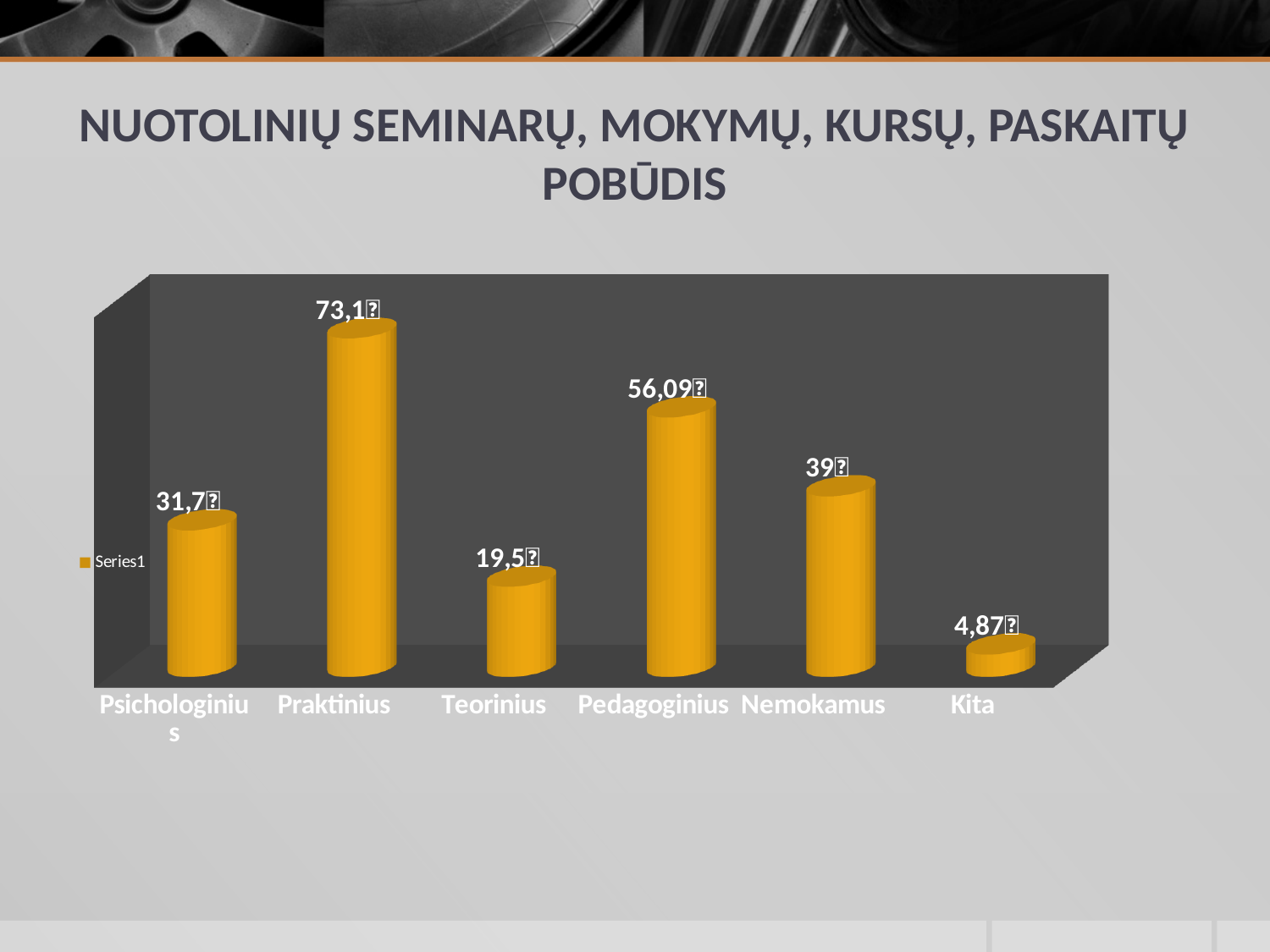
What value is shown for Praktinius? 73,1 How many categories are shown in the chart? 6 What value is shown for Kita? 4,87 Which category has the lowest value? Kita How many series does the legend list? 1 What value is shown for Pedagoginius? 56,09 What is the difference between the values for Pedagoginius and Nemokamus? 17,09 What kind of chart is shown on the slide? Bar chart Which category has the highest value? Praktinius Which is larger, the value for Teorinius or the value for Psichologinius? Psichologinius What is the difference between the values for Praktinius and Psichologinius? 41,4 What value is shown for Nemokamus? 39